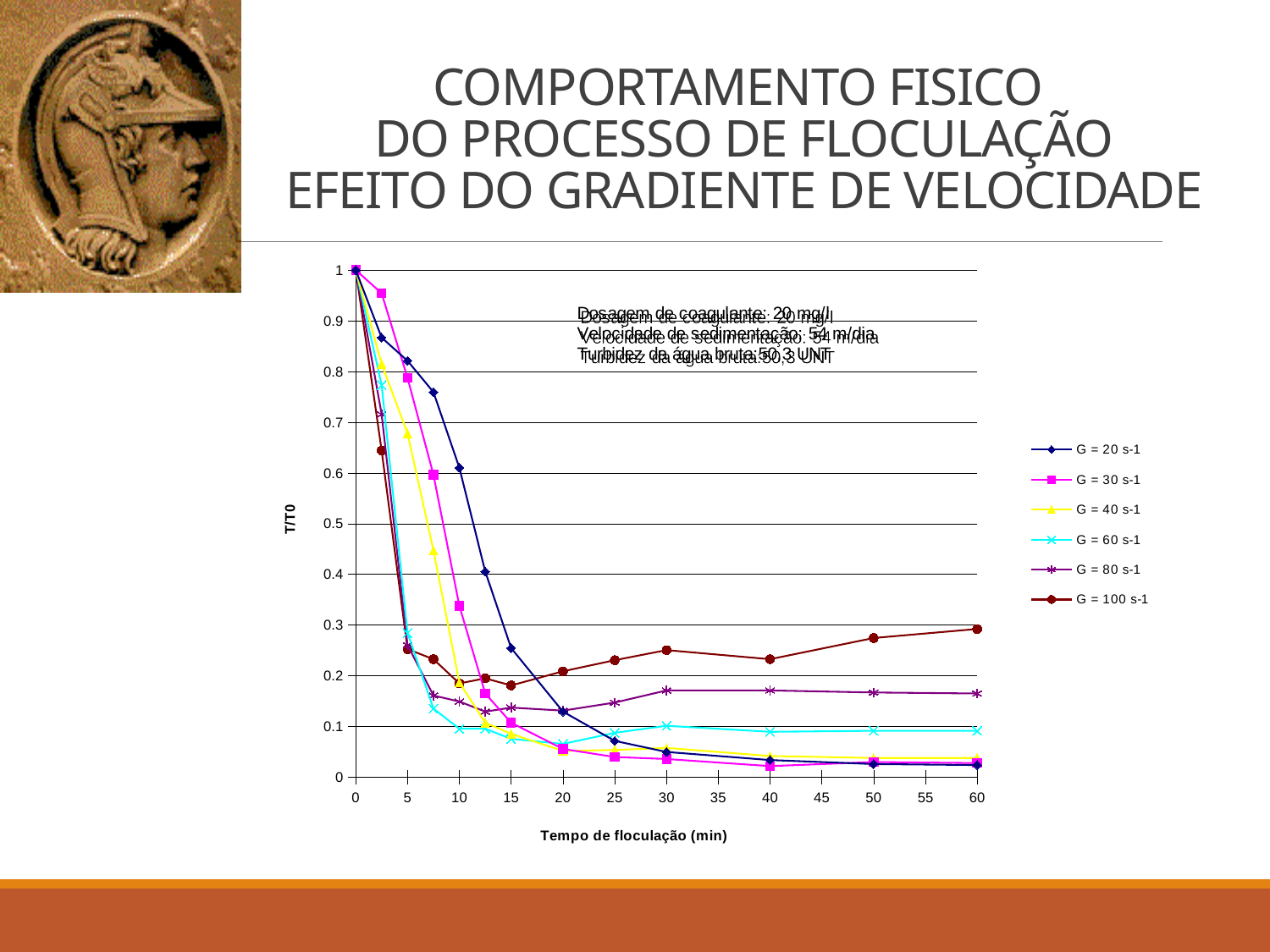
Does the G = 20 s-1 series rise or fall between 0 and 30 min? Fall Does the G = 100 s-1 series rise or fall between 15 and 60 min? Rise At 10 min, which is higher, G = 20 s-1 or G = 30 s-1? G = 20 s-1 At 60 min, which series has the highest T/T0 value? G = 100 s-1 Is the value for G = 30 s-1 at 5 min greater or less than 0.7? greater What is the T/T0 value of the series at 0 min? 1 Is the value for G = 100 s-1 at 60 min greater or less than 0.2? greater How many series does the legend list? 6 What is the label of the x axis? Tempo de floculação (min) Is the value for G = 80 s-1 at 30 min greater or less than 0.1? greater What kind of chart is shown on the slide? Line chart What is the label of the y axis? T/T0